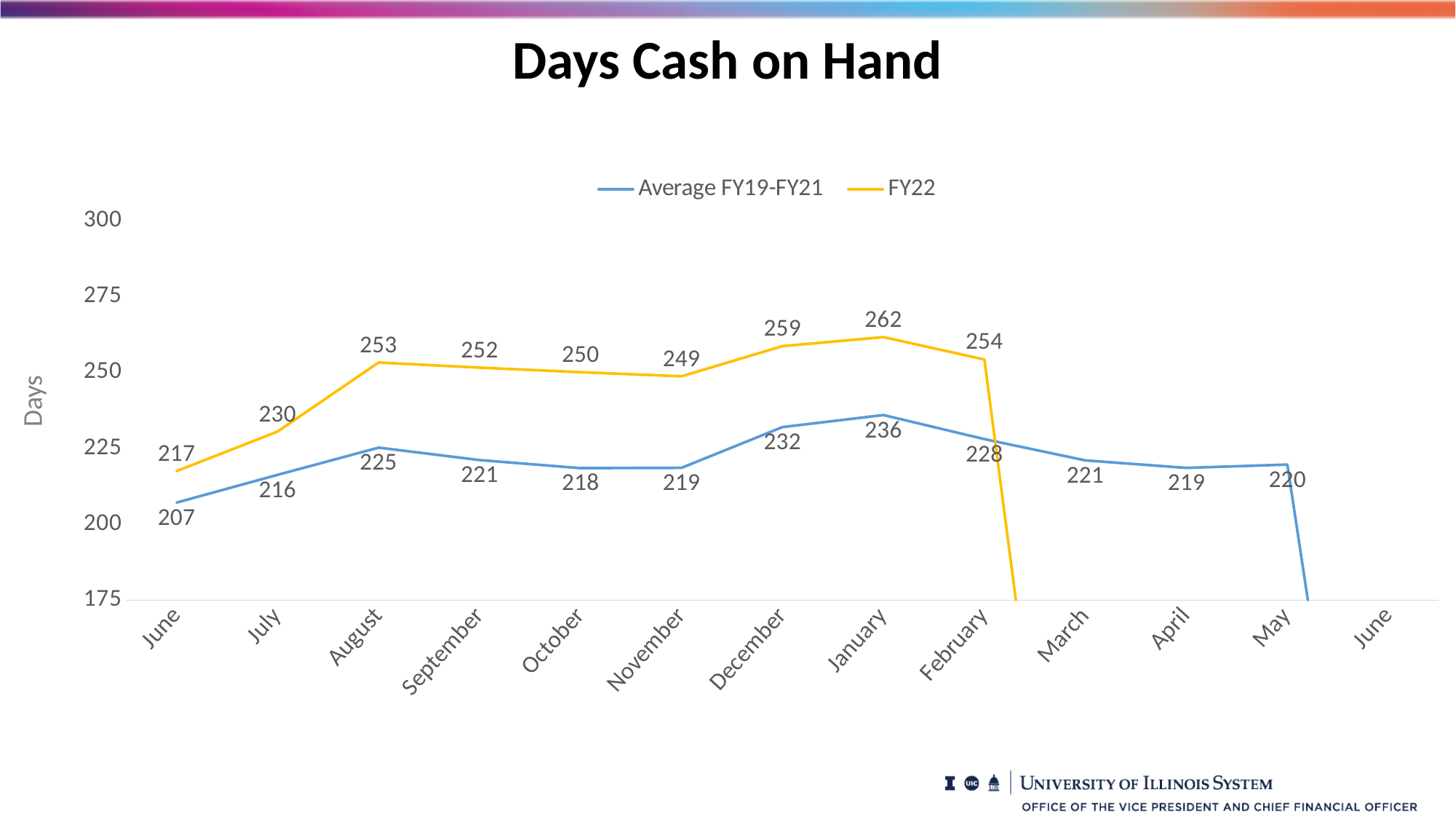
What is the difference between the FY22 value and the Average FY19-FY21 value in January? 26 What is the label on the vertical axis? Days In which month does the FY22 series reach its highest value? January In which month is the Average FY19-FY21 series at its lowest value? June What is the difference between the FY22 values for January and February? 8 What is the FY22 value for June? 217 Which is larger in February: the FY22 value or the Average FY19-FY21 value? FY22 What is the FY22 value for August? 253 What type of chart is shown on the slide? line chart How many series does the legend list? 2 Does the FY22 series rise or fall from June to August? rise What is the Average FY19-FY21 value for December? 232